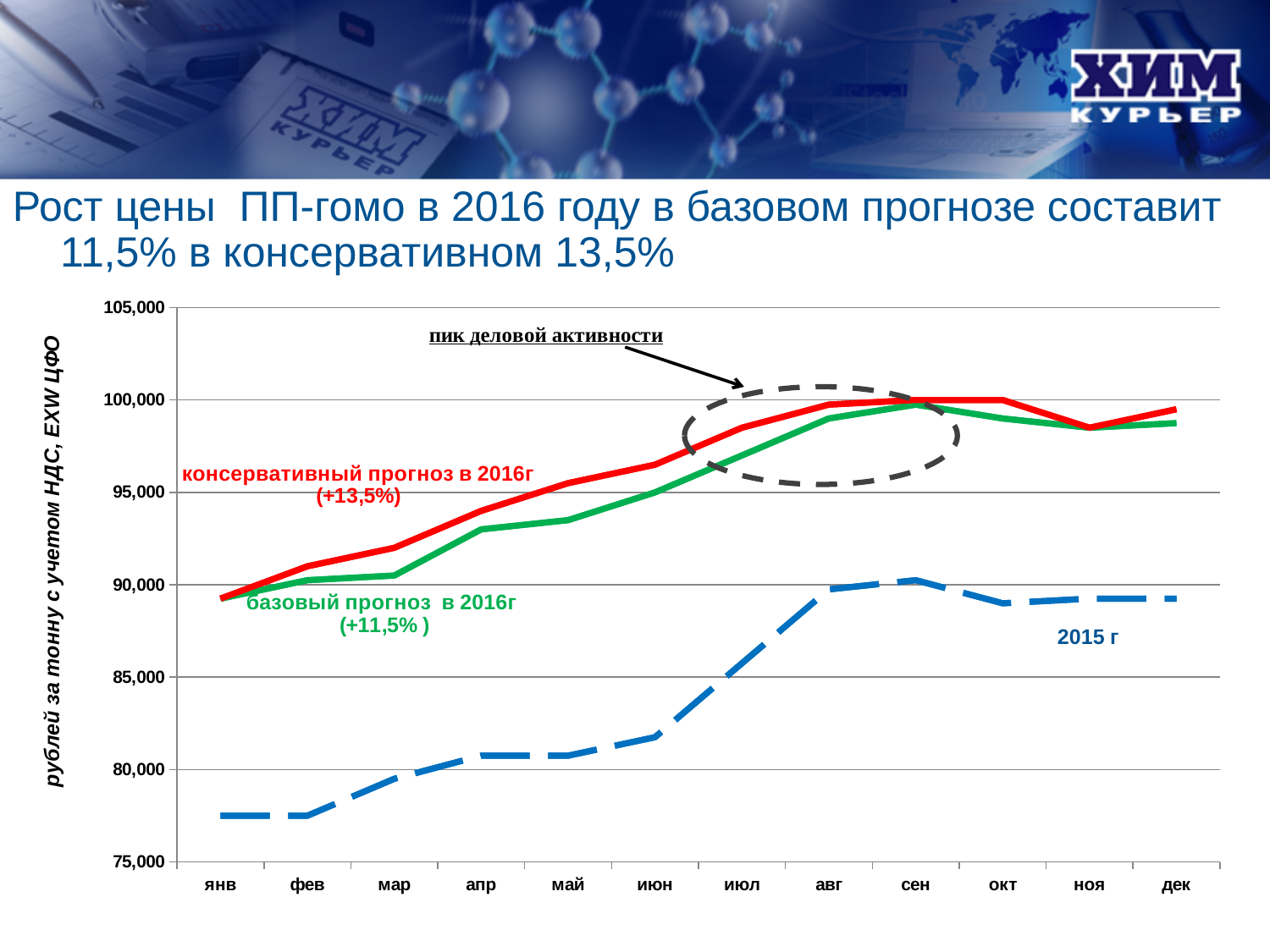
Which series has the highest value in июнь? консервативный прогноз в 2016г Is the value of the 2015 г line in янв greater or less than 80,000? less Is the value of the базовый прогноз в 2016г line in авг greater or less than 95,000? greater What does the annotation with the dashed oval on the chart say? пик деловой активности How many months are shown along the x axis of the chart? 12 Is the value of the 2015 г line in июнь greater or less than 80,000? greater Does the 2015 г line rise or fall from янв to сен? rise How many data series (lines) are plotted on the chart? 3 In май, which line is higher: консервативный прогноз в 2016г or базовый прогноз в 2016г? консервативный прогноз в 2016г What kind of chart is shown on the slide? line chart